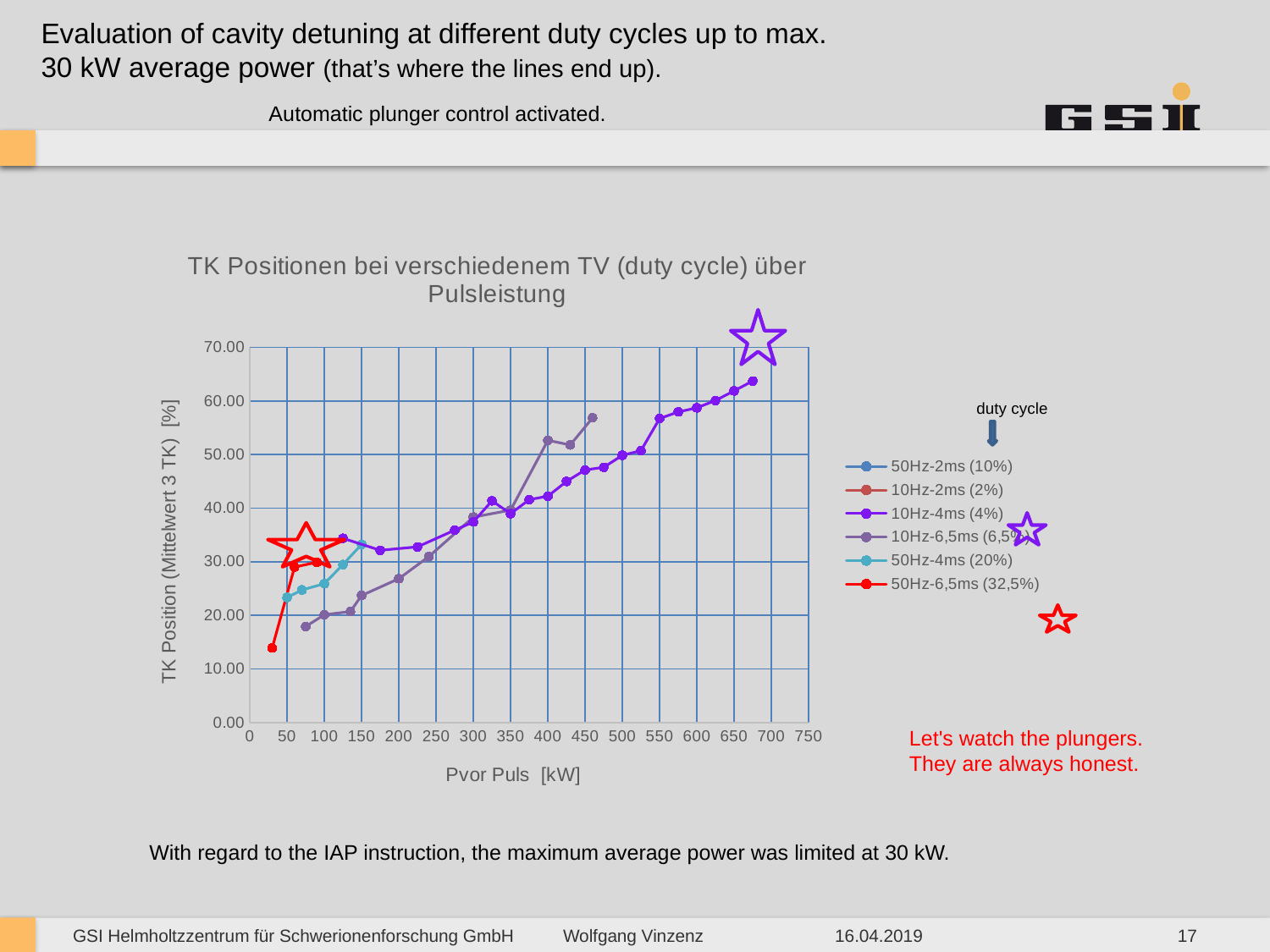
Is the highest value of the 10Hz-4ms (4%) series greater or less than 60.00? greater What is the label of the x axis? Pvor Puls [kW] Which series ends at the lowest Pvor Puls value on the x axis? 50Hz-6,5ms (32,5%) What is the title of the chart? TK Positionen bei verschiedenem TV (duty cycle) über Pulsleistung Is the lowest value of the 50Hz-6,5ms (32,5%) series greater or less than 20.00? less How many series does the legend list? 6 What is the highest tick value shown on the y axis? 70.00 Is the last (rightmost) value of the 10Hz-6,5ms (6,5%) series greater or less than 50.00? greater Does the TK Position of the 10Hz-4ms (4%) series generally rise or fall as Pvor Puls increases? rise What kind of chart is shown on the slide? line chart Which series reaches the highest TK Position value on the chart? 10Hz-4ms (4%) Which series extends to the highest Pvor Puls value on the x axis? 10Hz-4ms (4%)